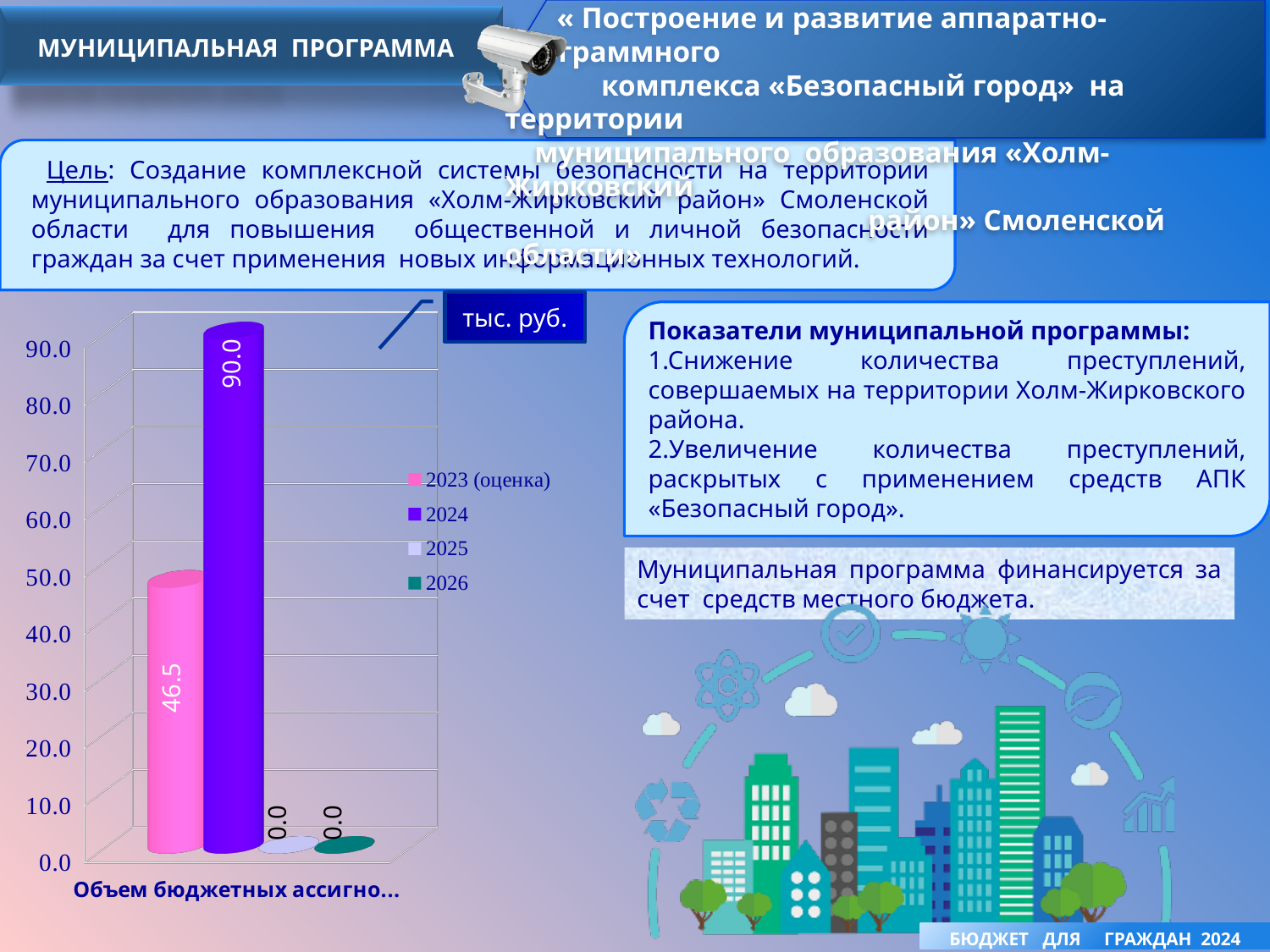
What kind of chart is shown on the slide? bar chart What is the difference between the values for 2024 and 2023 (оценка)? 43.5 Which is larger, the value for 2023 (оценка) or the value for 2024? 2024 What is the value for 2026 on the chart? 0.0 What unit of measurement is shown for the chart values? тыс. руб. What is the value for 2023 (оценка) on the chart? 46.5 What is the value for 2024 on the chart? 90.0 What is the value for 2025 on the chart? 0.0 Is the value for 2023 (оценка) greater or less than 50.0? less Which series has the highest value on the chart? 2024 How many series does the chart legend list? 4 What colour is the bar for 2024 in the chart? purple